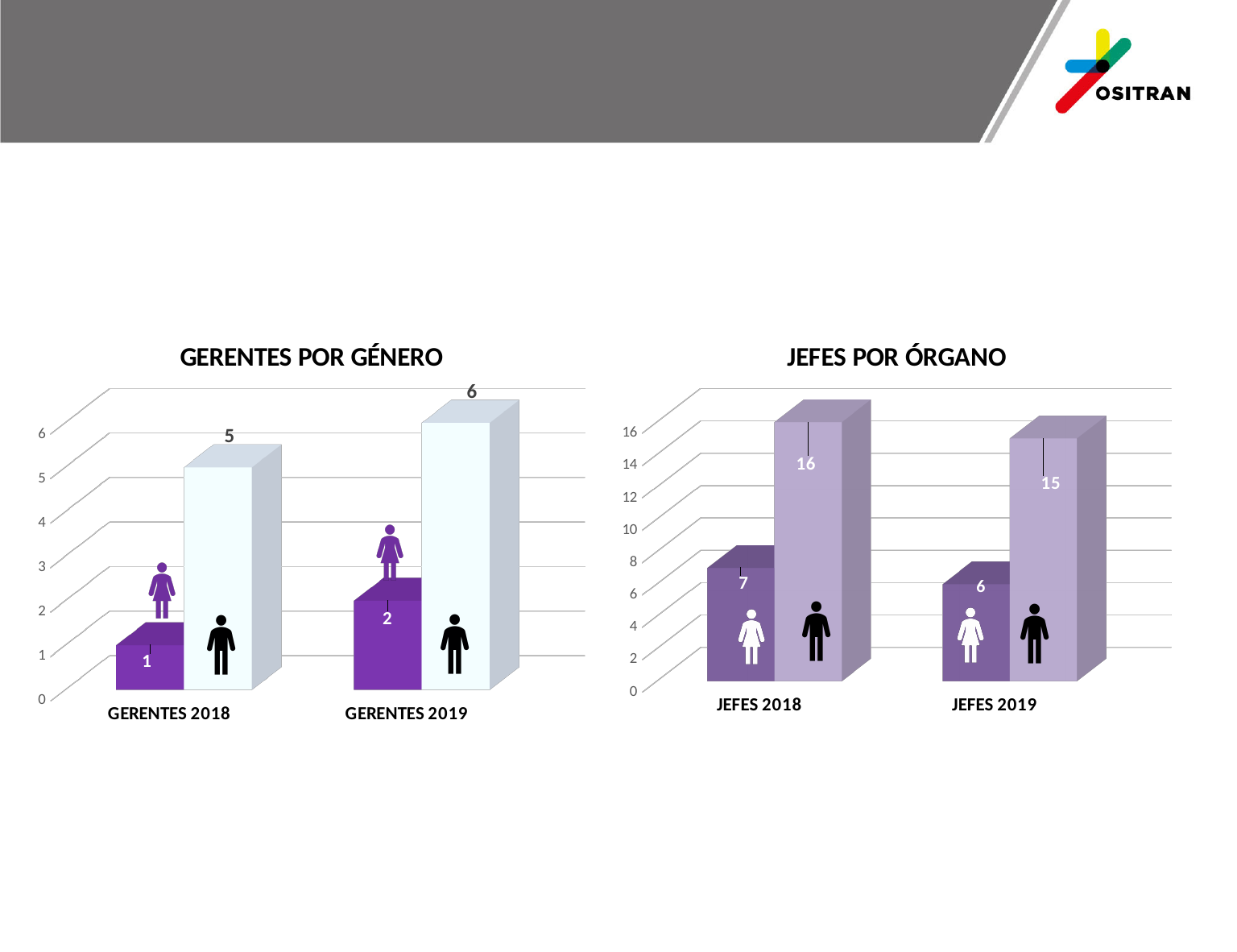
In the JEFES POR ÓRGANO chart, what is the value of the bar with the male icon for JEFES 2018? 16 In the GERENTES POR GÉNERO chart, which bar has the lowest value? GERENTES 2018, female icon (1) In the GERENTES POR GÉNERO chart, what is the value of the bar with the female icon for GERENTES 2018? 1 How many categories are shown on the x axis of the GERENTES POR GÉNERO chart? 2 In the JEFES POR ÓRGANO chart, what is the difference between the male-icon bars for JEFES 2018 and JEFES 2019? 1 What kind of chart is the JEFES POR ÓRGANO chart? Bar chart In the GERENTES POR GÉNERO chart, what is the value of the bar with the male icon for GERENTES 2019? 6 In the GERENTES POR GÉNERO chart, what is the difference between the male-icon bar and the female-icon bar for GERENTES 2018? 4 In the JEFES POR ÓRGANO chart, which is larger: the female-icon bar for JEFES 2018 or the female-icon bar for JEFES 2019? JEFES 2018 In the JEFES POR ÓRGANO chart, which bar has the highest value? JEFES 2018, male icon (16) What is the title of the chart on the right side of the slide? JEFES POR ÓRGANO In the JEFES POR ÓRGANO chart, what is the value of the bar with the female icon for JEFES 2019? 6